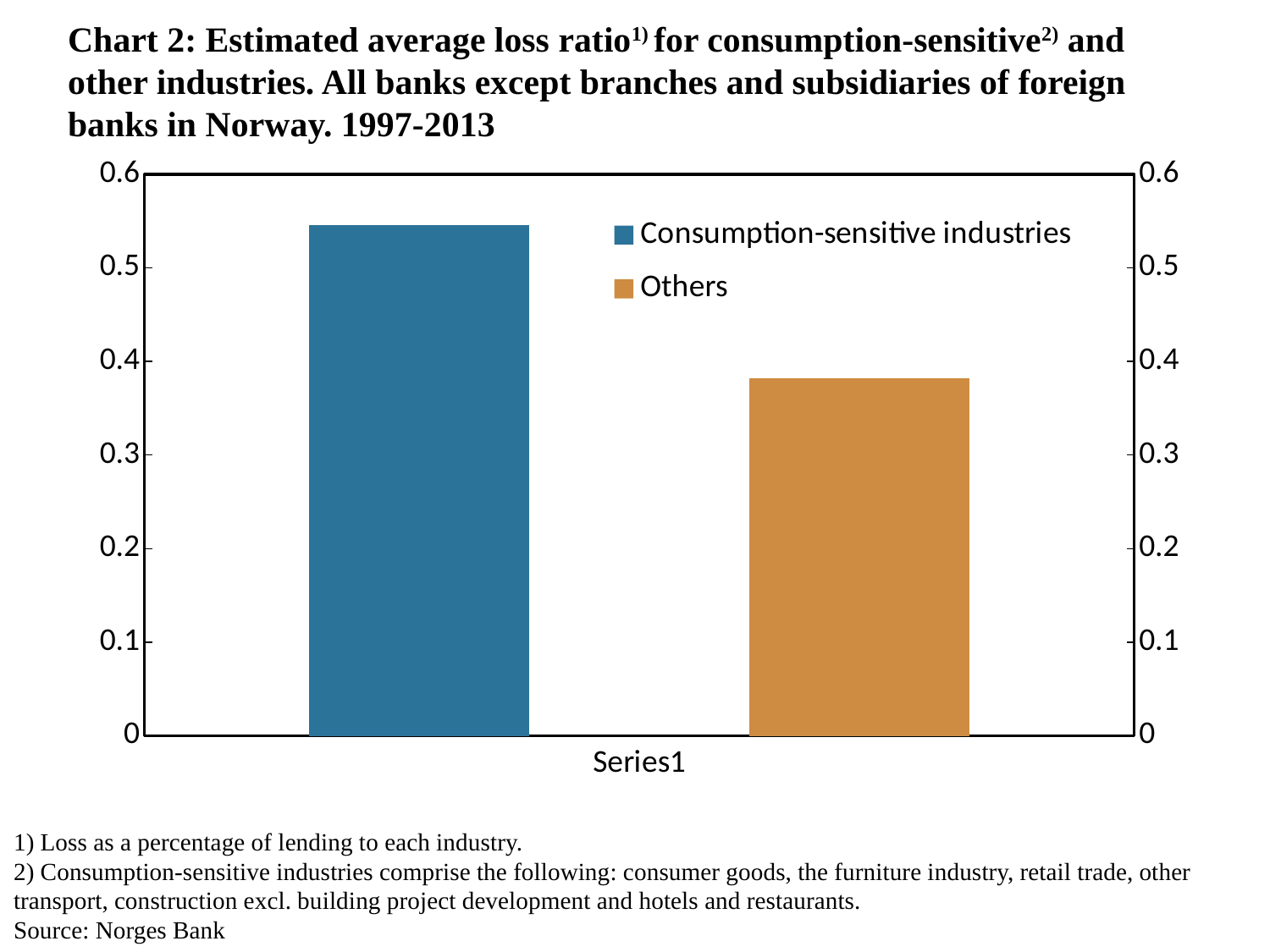
Is the value for Consumption-sensitive industries greater or less than 0.5? greater What is the source cited for the chart? Norges Bank Is the value for Others greater or less than 0.4? less Is the value for Others greater or less than 0.3? greater How many series does the legend list? 2 How many bars are plotted in the chart? 2 What kind of chart is shown on the slide? bar chart What colour is the bar for Others? orange Which is larger, the loss ratio for Consumption-sensitive industries or for Others? Consumption-sensitive industries Which series has the higher estimated average loss ratio? Consumption-sensitive industries Which series has the lower estimated average loss ratio? Others